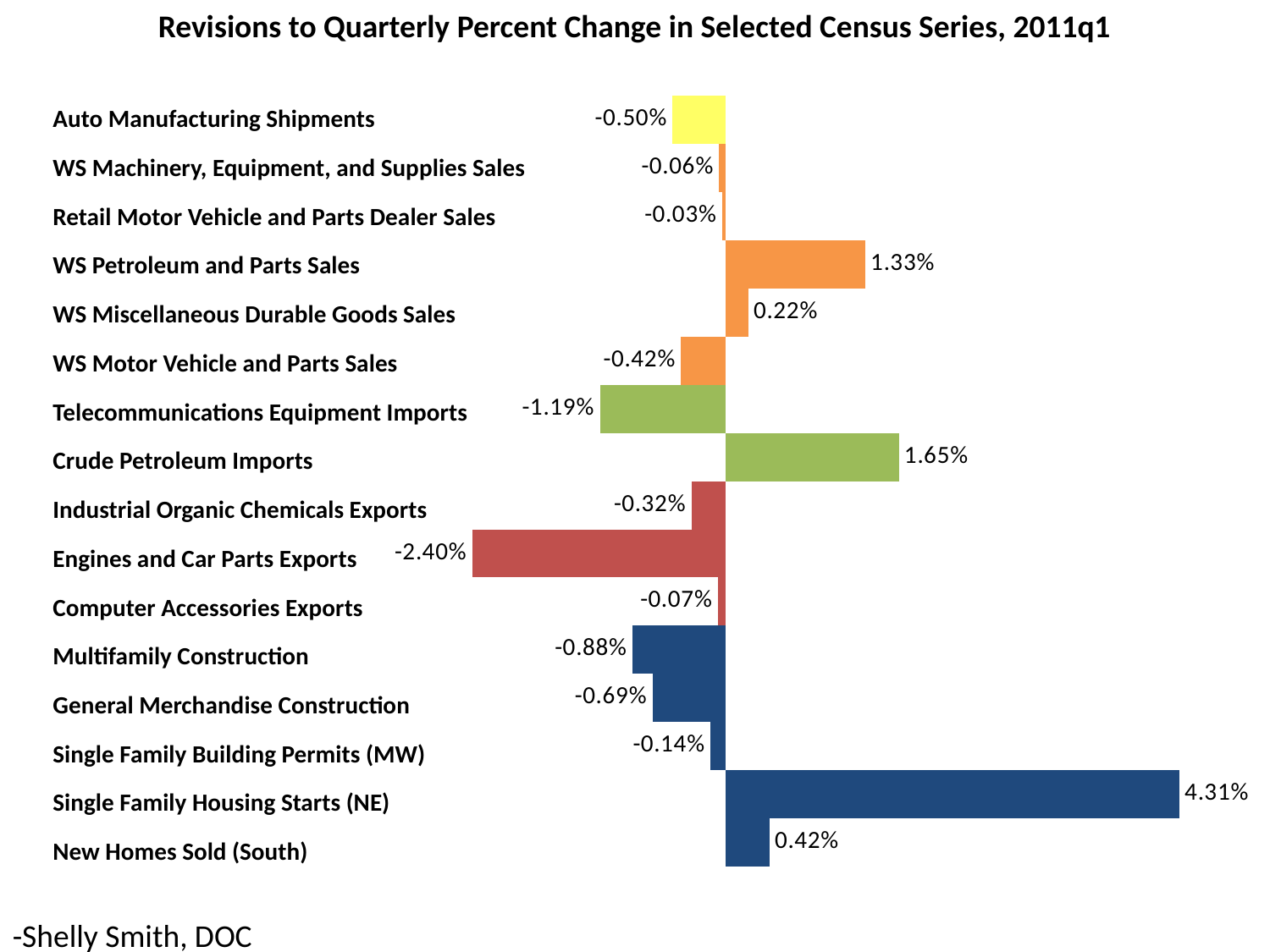
What is the revision value for Engines and Car Parts Exports? -2.40% What is the title of the chart? Revisions to Quarterly Percent Change in Selected Census Series, 2011q1 What is the revision value for Telecommunications Equipment Imports? -1.19% What is the revision value for Crude Petroleum Imports? 1.65% What kind of chart is shown on the slide? Bar chart Which series has the lowest revision value? Engines and Car Parts Exports What is the revision value for Single Family Housing Starts (NE)? 4.31% What is the difference between the revision values for Crude Petroleum Imports and WS Petroleum and Parts Sales? 0.32% How many series are plotted in the chart? 16 What is the revision value for Multifamily Construction? -0.88% Which has a larger revision value, WS Miscellaneous Durable Goods Sales or New Homes Sold (South)? New Homes Sold (South) Which series has the highest revision value? Single Family Housing Starts (NE)